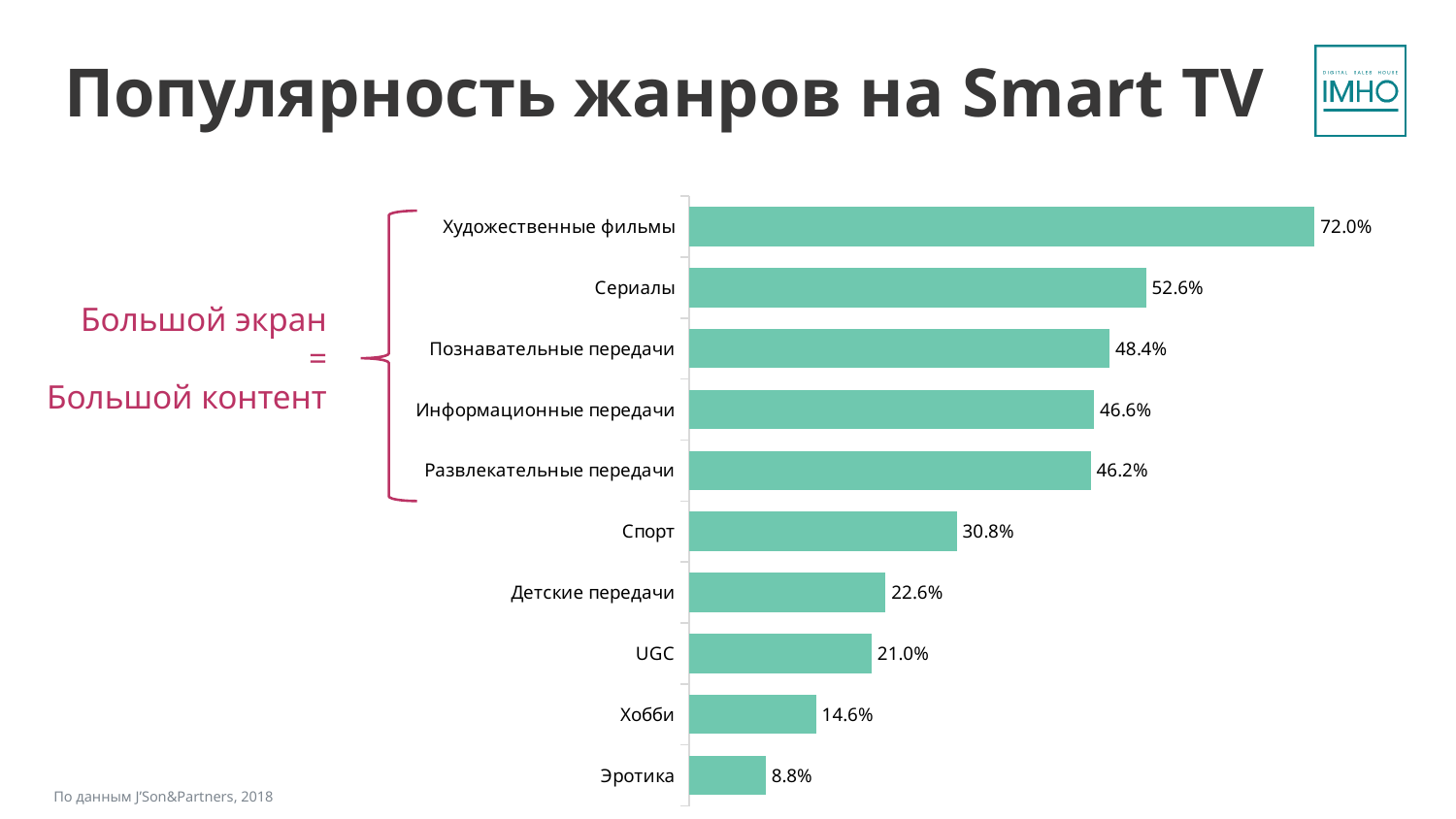
What is the value for Художественные фильмы? 72.0% Which category has the highest value? Художественные фильмы How many categories are shown in the chart? 10 What kind of chart is shown on the slide? Bar chart Which category has the lowest value? Эротика What is the value for Спорт? 30.8% What is the difference between the values for Художественные фильмы and Эротика? 63.2% Which is larger, the value for Детские передачи or the value for Хобби? Детские передачи What is the difference between the values for Сериалы and Познавательные передачи? 4.2% What is the value for Информационные передачи? 46.6% What is the value for UGC? 21.0% What is the title of the slide containing the chart? Популярность жанров на Smart TV